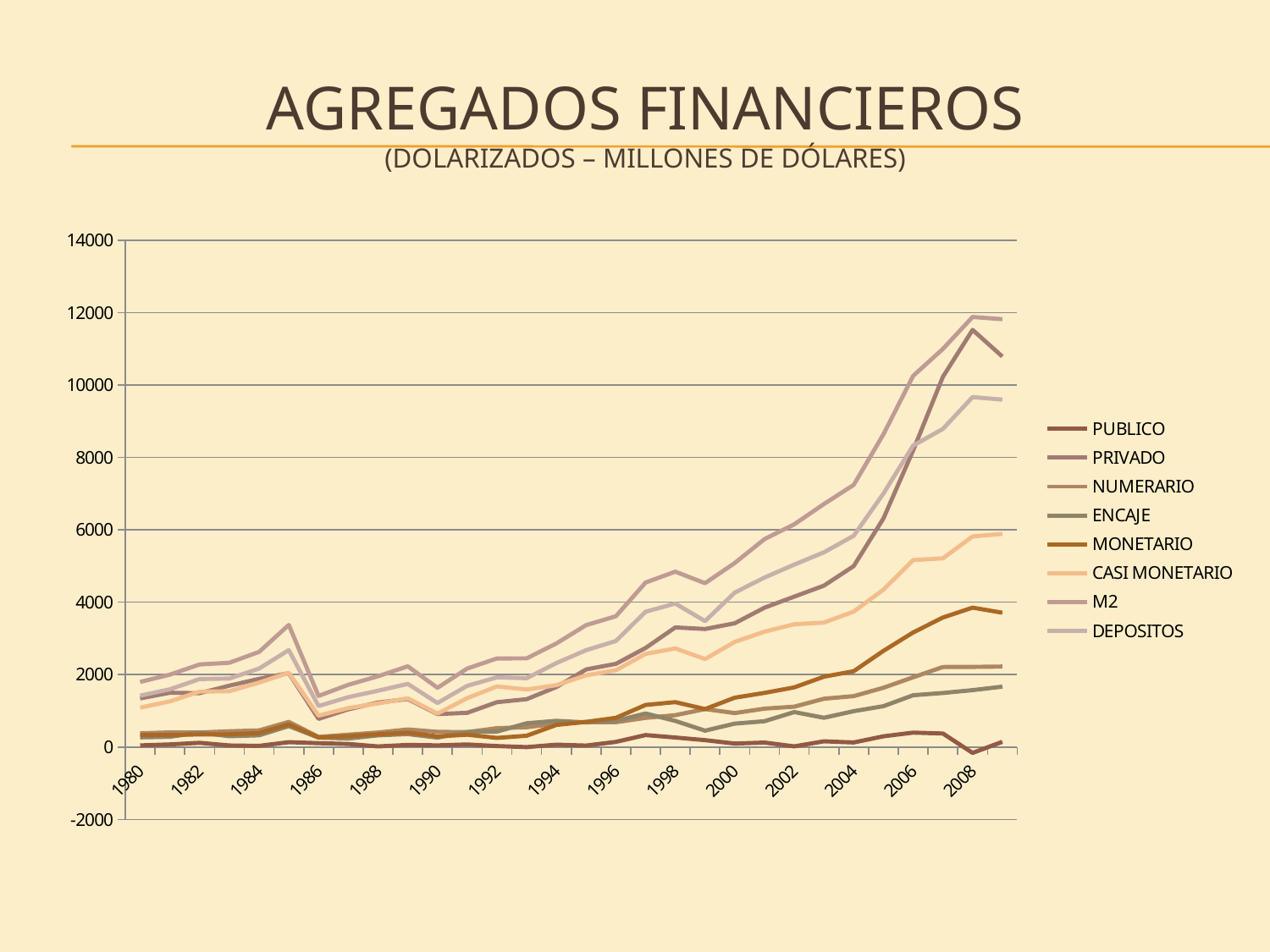
Which is larger in 2008, M2 or DEPOSITOS? M2 Is the value for DEPOSITOS in 2008 greater or less than 10000? less Which series reaches the highest value on the chart? M2 What kind of chart is shown on the slide? line chart What is the first year shown on the x axis? 1980 How many series does the legend list? 8 Does the M2 series rise or fall between 2000 and 2008? rise Is the value for MONETARIO in 2008 greater or less than 4000? less Which series stays lowest across the chart? PUBLICO Is the value for M2 in 2008 greater or less than 10000? greater What is the title of the chart on the slide? AGREGADOS FINANCIEROS